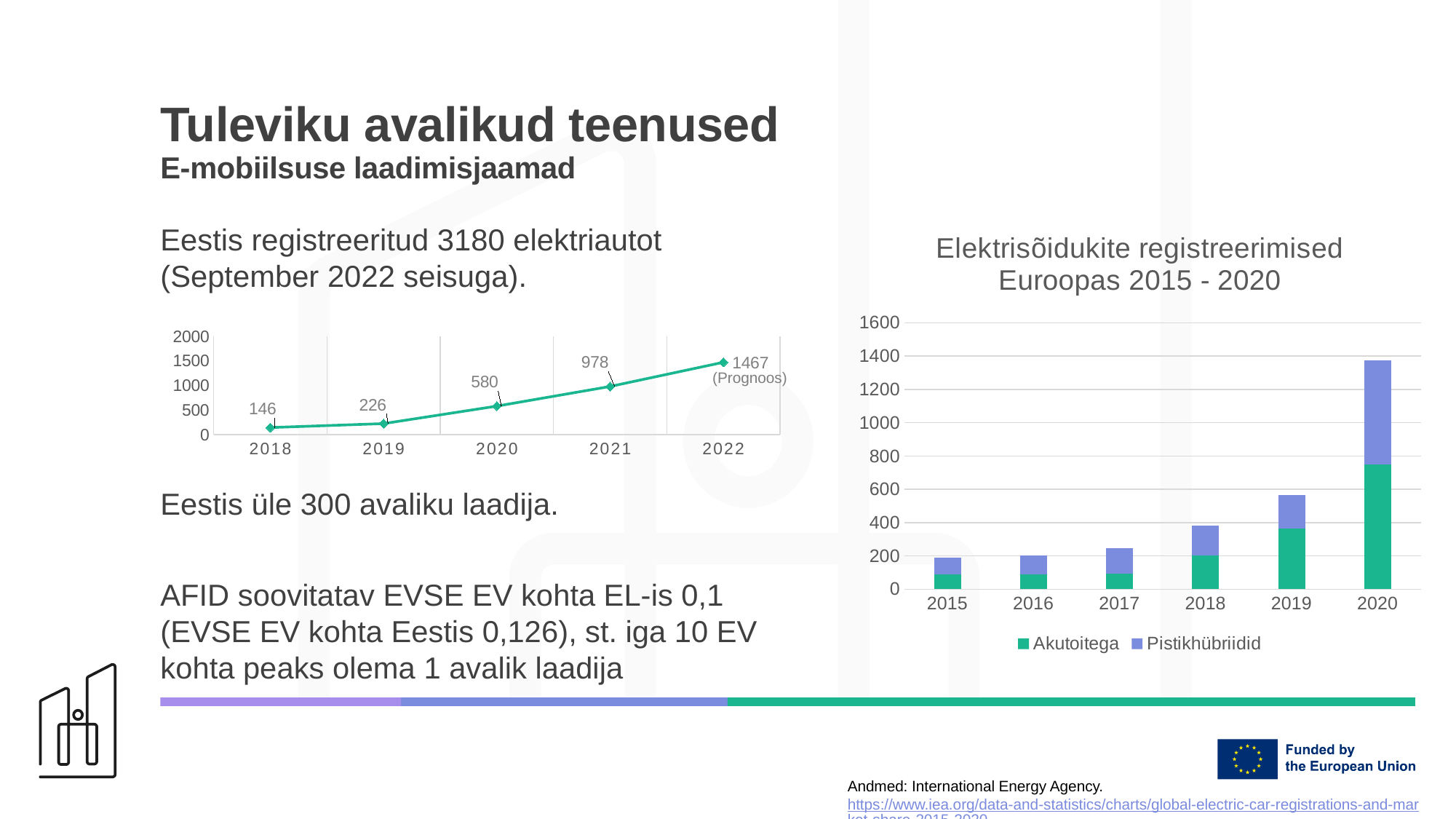
In the line chart on the left of the slide, what is the value for 2018? 146 In the chart titled 'Elektrisõidukite registreerimised Euroopas 2015 - 2020', is the total value for 2020 greater or less than 1200? greater In the chart titled 'Elektrisõidukite registreerimised Euroopas 2015 - 2020', which year has the tallest bar? 2020 In the line chart on the left of the slide, what is the forecast (Prognoos) value for 2022? 1467 In the line chart on the left of the slide, which year has the highest value? 2022 In the line chart on the left of the slide, do the values rise or fall from 2018 to 2022? rise What kind of chart is the chart titled 'Elektrisõidukite registreerimised Euroopas 2015 - 2020'? stacked bar chart In the line chart on the left of the slide, which year has the lowest value? 2018 In the line chart on the left of the slide, how many data points are plotted? 5 In the chart titled 'Elektrisõidukite registreerimised Euroopas 2015 - 2020', how many series does the legend list? 2 In the line chart on the left of the slide, what is the difference between the values for 2021 and 2020? 398 In the line chart on the left of the slide, what is the value for 2020? 580